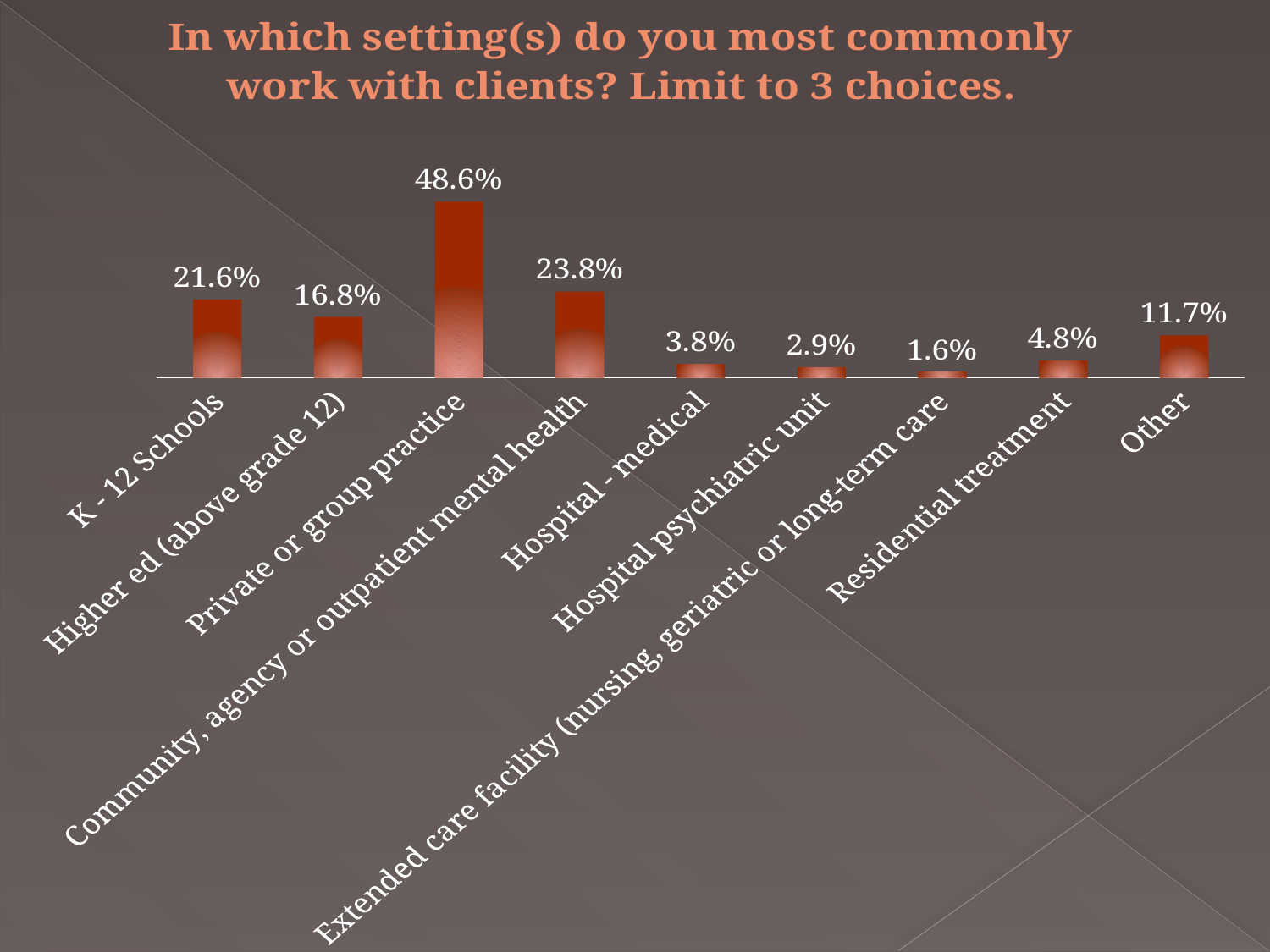
Which setting has the lowest percentage? Extended care facility (nursing, geriatric or long-term care Which setting has the highest percentage? Private or group practice What is the difference between K - 12 Schools and Higher ed (above grade 12)? 4.8% Which is larger, Hospital - medical or Residential treatment? Residential treatment How many settings (categories) are shown in the chart? 9 What is the title of the chart? In which setting(s) do you most commonly work with clients? Limit to 3 choices. What is the value for Hospital psychiatric unit? 2.9% Which is larger, Other or Higher ed (above grade 12)? Higher ed (above grade 12) What is the value for K - 12 Schools? 21.6% What percentage of respondents selected Private or group practice? 48.6% What is the difference between Private or group practice and Community, agency or outpatient mental health? 24.8% What kind of chart is shown on the slide? Bar chart